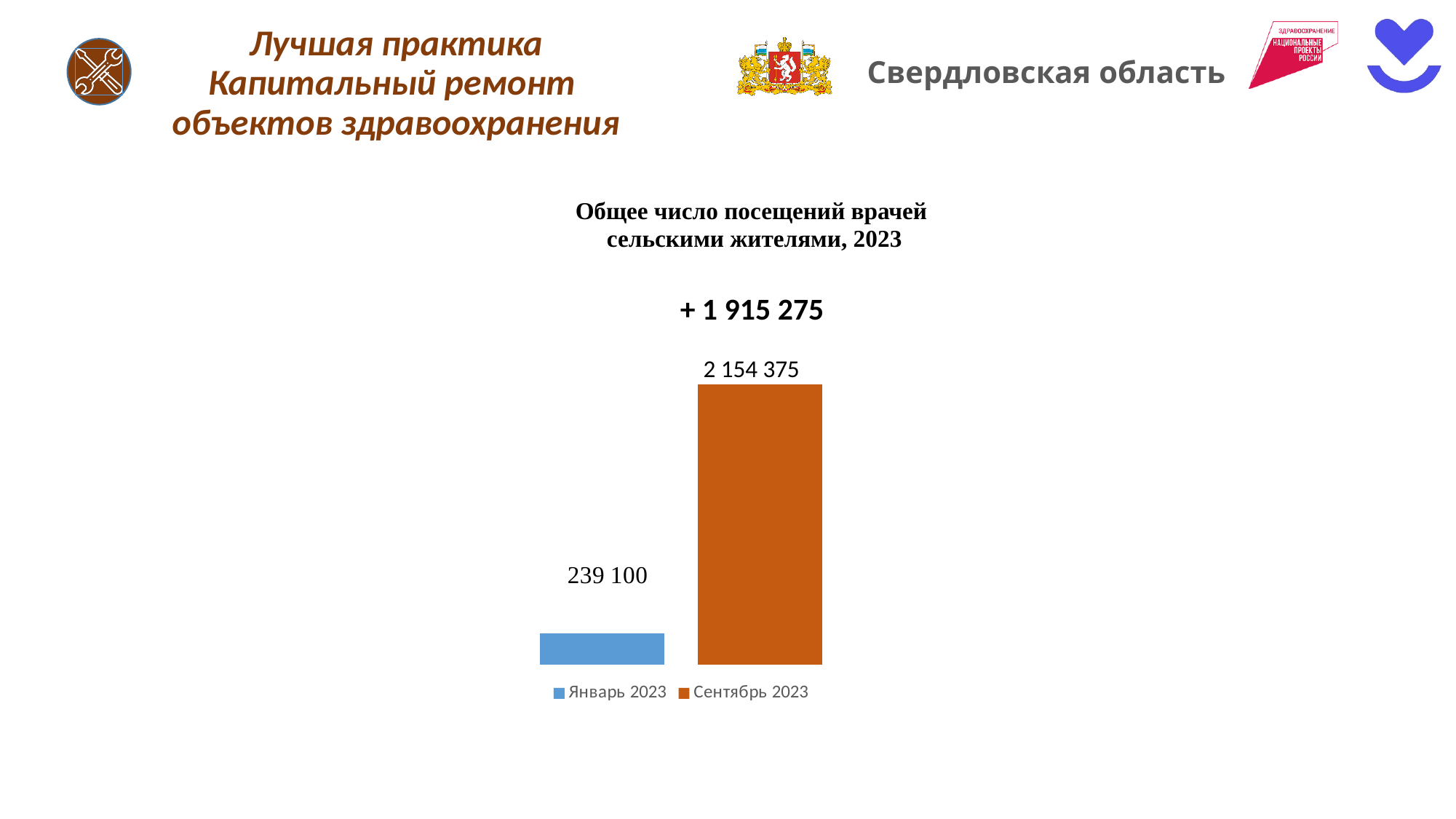
What is the difference between the values for Сентябрь 2023 and Январь 2023? 1 915 275 How many bars are plotted on the chart? 2 How many series does the legend list? 2 What is the value for Сентябрь 2023? 2 154 375 What colour is the bar for Сентябрь 2023? Orange Do the values rise or fall from Январь 2023 to Сентябрь 2023? Rise Which series has the lowest value? Январь 2023 Which series has the highest value? Сентябрь 2023 Which is larger, the value for Январь 2023 or the value for Сентябрь 2023? Сентябрь 2023 What is the value for Январь 2023? 239 100 What kind of chart is shown on the slide? Bar chart What is the title of the chart? Общее число посещений врачей сельскими жителями, 2023